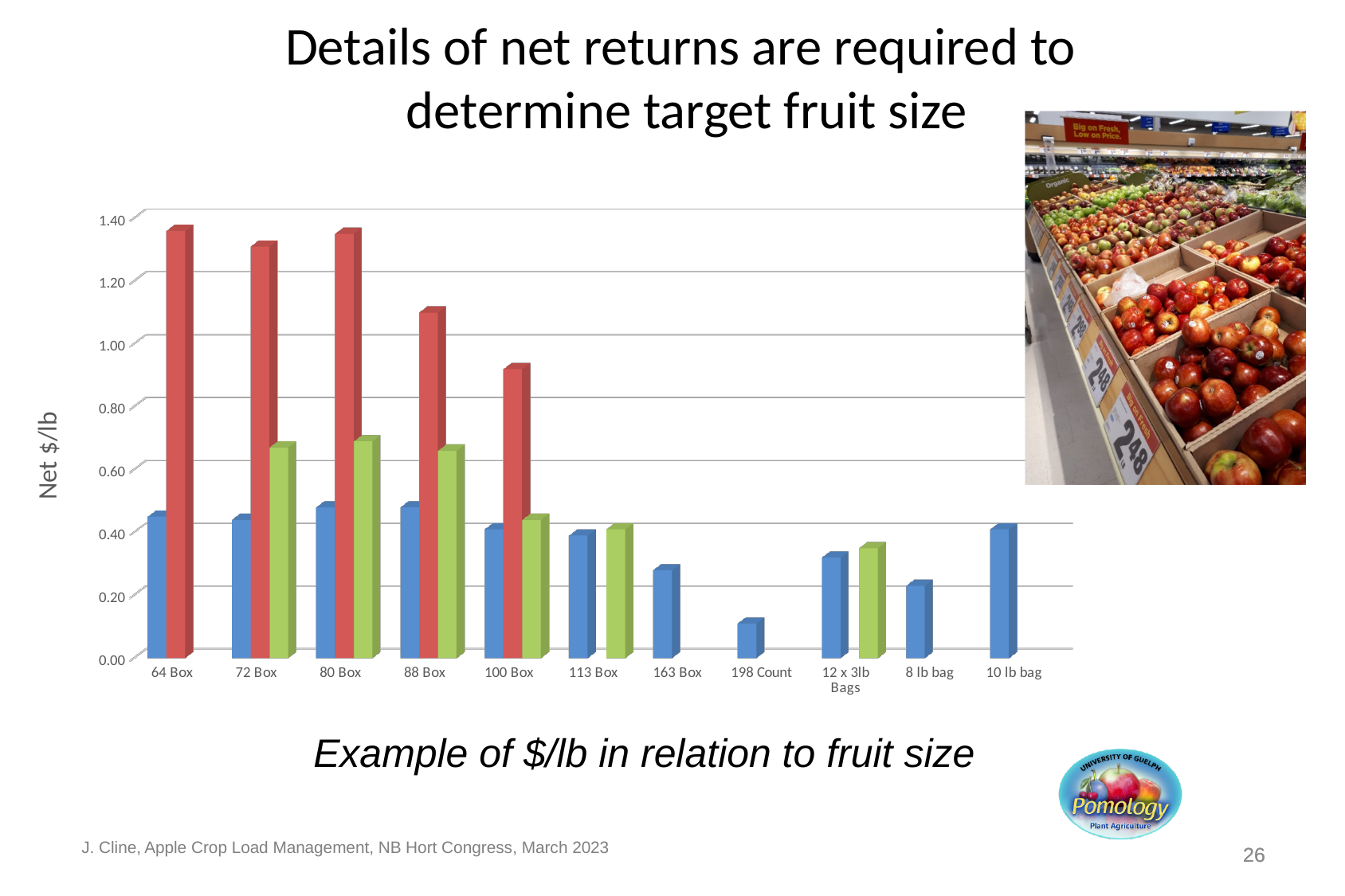
Is the red bar for 64 Box greater or less than 1.20? greater What is the label of the vertical axis of the chart? Net $/lb What kind of chart is shown on the slide? bar chart How many categories are shown along the x axis of the chart? 11 Is the green bar for 72 Box greater or less than 0.60? greater Is the blue bar for 198 Count greater or less than 0.20? less Which is larger for 64 Box, the red bar or the blue bar? the red bar Do the red bars rise or fall from 64 Box to 100 Box? fall Which category has the lowest blue bar? 198 Count How many categories in the chart have a red bar? 5